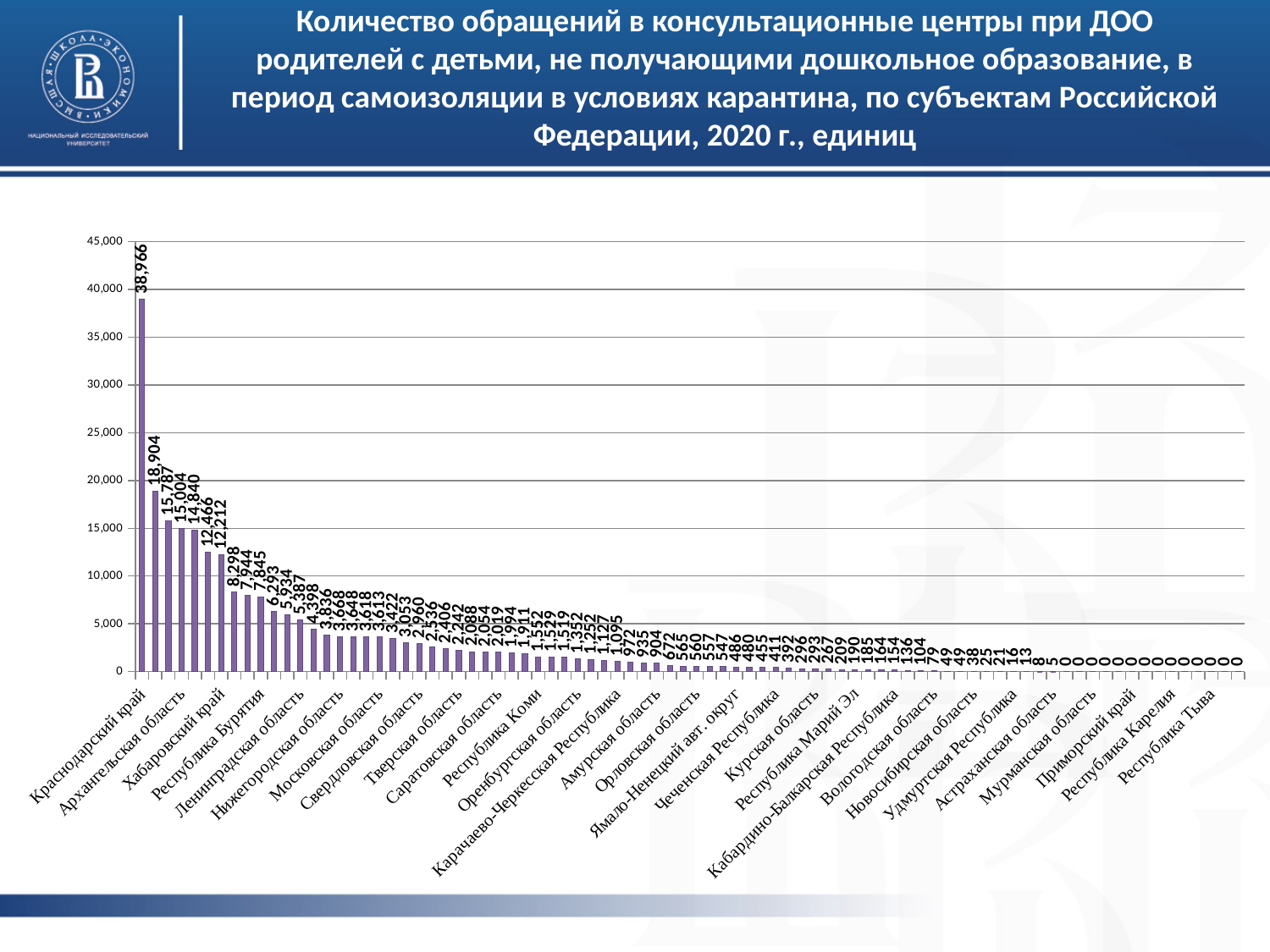
What type of chart is shown on the slide? bar chart Do the values rise or fall moving from left to right along the x axis? fall Is the value for Краснодарский край greater or less than 35,000? greater Is the value for Московская область greater or less than 5,000? less What is the difference between the highest value (38,966) and the second-highest value (18,904)? 20,062 What is the value for Краснодарский край? 38,966 Which region has the highest number of requests? Краснодарский край Is the value for Республика Бурятия greater or less than 10,000? less Which is larger, the value for Краснодарский край or the value for Республика Карелия? Краснодарский край What is the value for Республика Тыва? 0 What is the value for Приморский край? 0 What is the second-highest value shown on the chart? 18,904